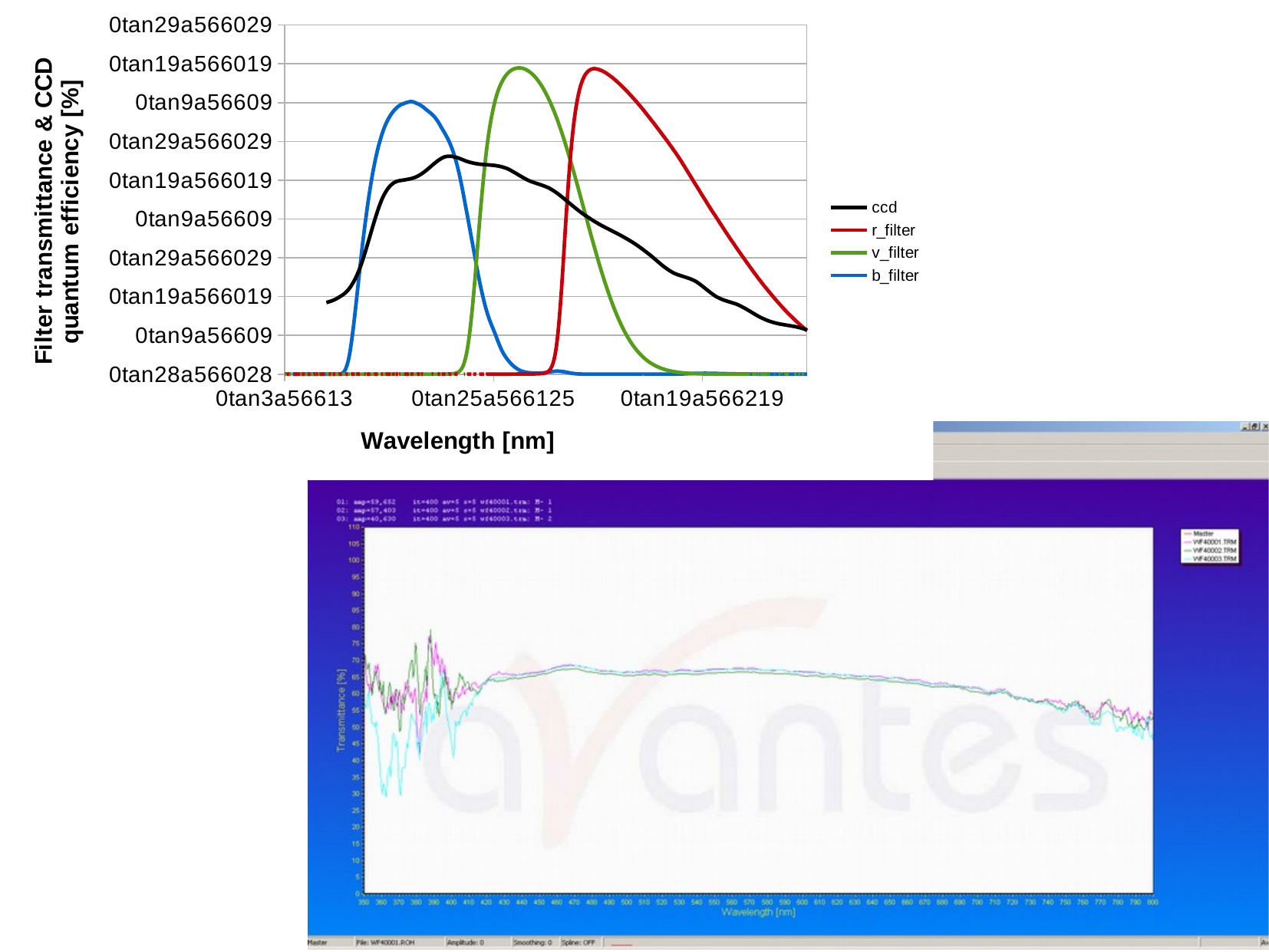
What is the x-axis title of the bottom chart? Wavelength [nm] In the top chart, what colour is the b_filter line? blue What kind of chart is the top chart on the slide? line chart How many series does the legend of the top chart list? 4 In the top chart, which filter curve peaks at the shortest wavelength (furthest left on the x axis)? b_filter In the top chart, which peaks higher, the r_filter curve or the ccd curve? r_filter How many series does the legend of the bottom chart list? 4 In the top chart, which peaks higher, the v_filter curve or the b_filter curve? v_filter In the bottom chart, is the transmittance value at 600 nm greater or less than 50? greater In the top chart, does the r_filter curve rise or fall along the x axis after its peak? fall In the top chart, which series has the lowest peak value? ccd